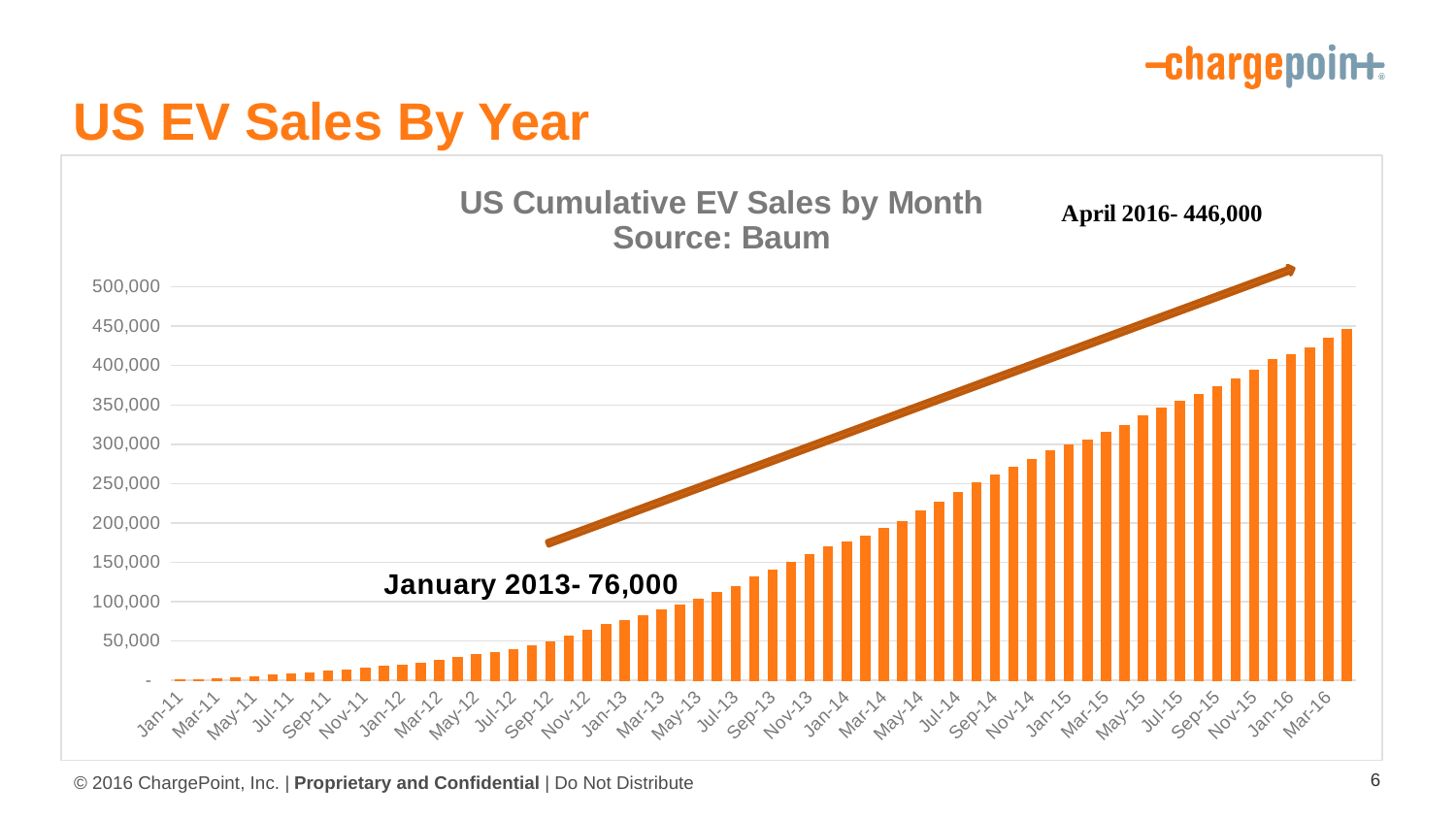
Which month has the lowest cumulative EV sales in the chart? Jan-11 Do the cumulative EV sales values rise or fall from left to right along the x axis? rise What is the cumulative EV sales value annotated for April 2016? 446,000 Is the value for Jan-15 greater or less than 250,000? greater What is the source cited in the chart title? Baum Is the value for Jul-13 greater or less than 150,000? less What is the difference between the annotated April 2016 value and the annotated January 2013 value? 370,000 What is the title of the chart? US Cumulative EV Sales by Month Source: Baum Which is larger, the value for Jan-16 or the value for Jan-15? Jan-16 Is the value for Nov-15 greater or less than 350,000? greater What is the cumulative EV sales value annotated for January 2013? 76,000 What kind of chart is shown on the slide? bar chart